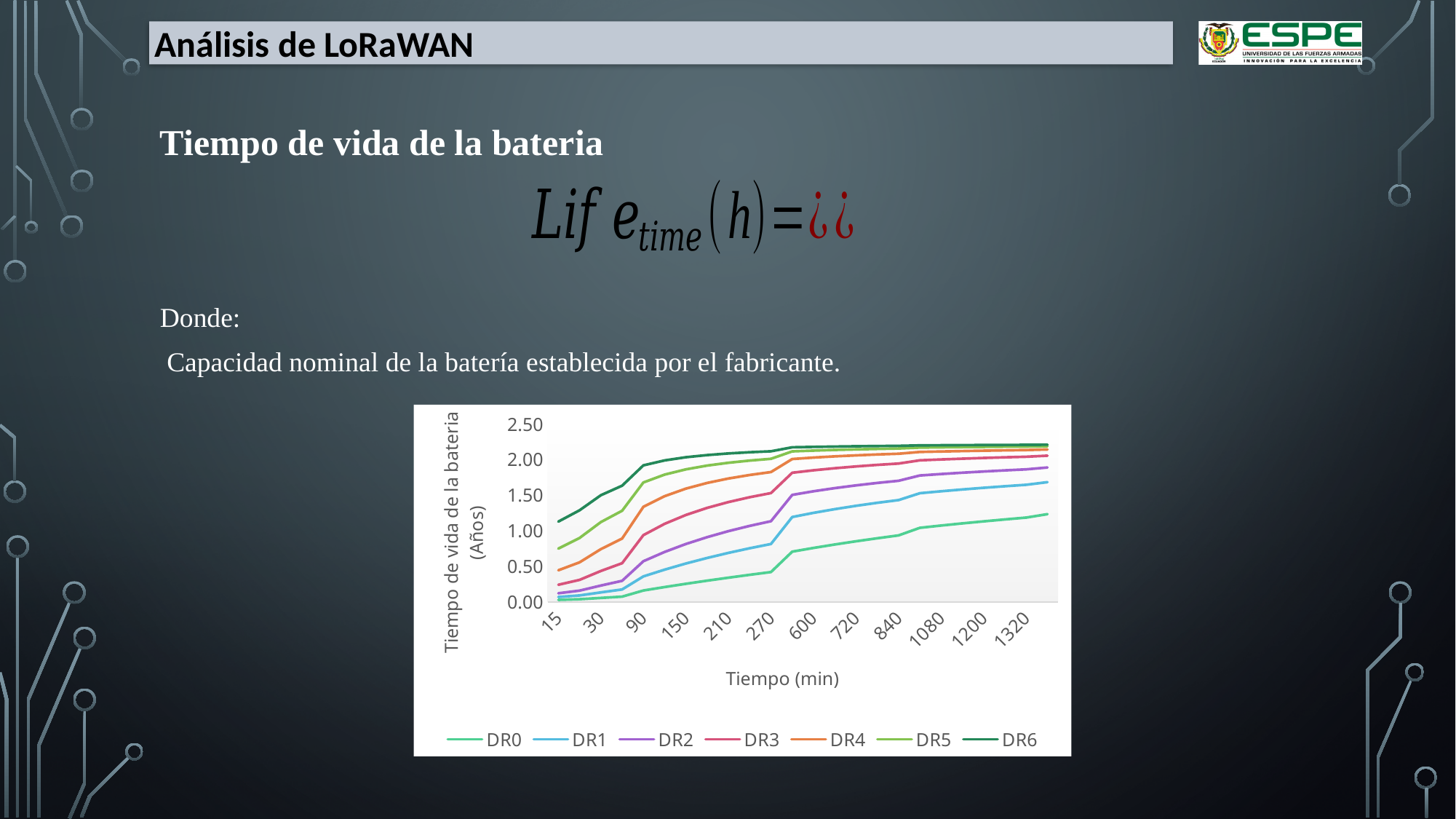
Which series has the lowest battery lifetime at 15 min? DR0 Do the values for DR0 rise or fall as time increases along the x axis? rise What is the title of the y axis? Tiempo de vida de la bateria (Años) Is the value for DR6 at 15 min greater or less than 1.00? greater Is the value for DR6 at 1320 min greater or less than 2.00? greater Which series has the highest battery lifetime at 15 min? DR6 Is the value for DR0 at 15 min greater or less than 0.50? less What is the title of the x axis? Tiempo (min) What kind of chart is shown on the slide? line chart At 1320 min, which is larger, the value for DR4 or the value for DR0? DR4 How many series does the chart legend list? 7